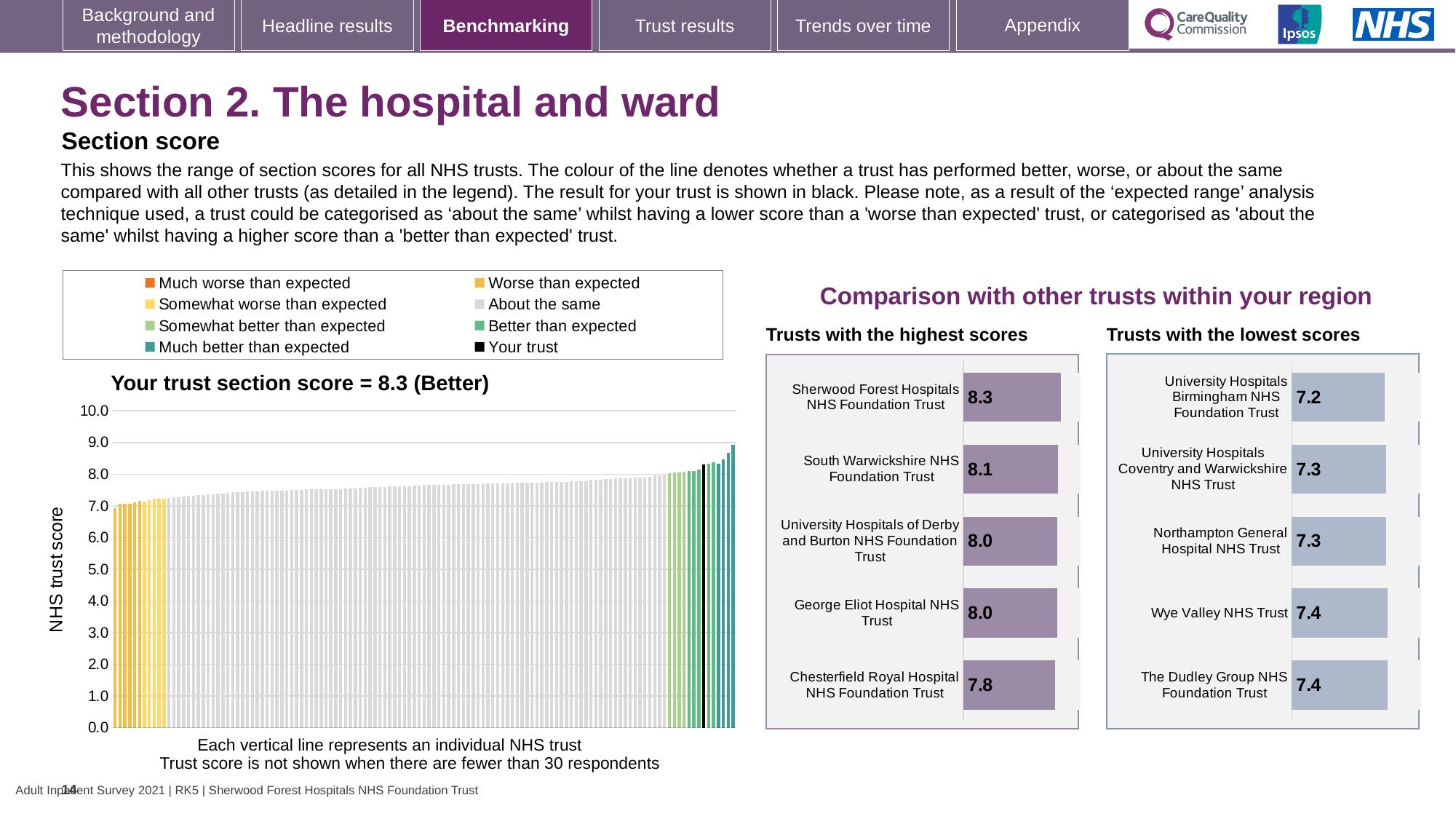
In the 'Your trust section score' chart, how many entries does the legend list? 8 In the 'Your trust section score' chart, what is the section score for your trust, as stated in the chart title? 8.3 In the 'Your trust section score' chart, do the bar heights rise or fall from left to right? Rise In the 'Your trust section score' chart, what kind of chart is shown? Bar chart In the 'Trusts with the highest scores' chart, which trust has the highest score? Sherwood Forest Hospitals NHS Foundation Trust In the 'Trusts with the lowest scores' chart, which has the larger score: Wye Valley NHS Trust or University Hospitals Birmingham NHS Foundation Trust? Wye Valley NHS Trust In the 'Trusts with the lowest scores' chart, which trust has the lowest score? University Hospitals Birmingham NHS Foundation Trust In the 'Trusts with the highest scores' chart, what is the score for South Warwickshire NHS Foundation Trust? 8.1 In the 'Trusts with the highest scores' chart, how many trusts are shown? 5 In the 'Your trust section score' chart, what is the label on the vertical axis? NHS trust score In the 'Trusts with the highest scores' chart, what is the difference between the scores of Sherwood Forest Hospitals NHS Foundation Trust and Chesterfield Royal Hospital NHS Foundation Trust? 0.5 In the 'Trusts with the lowest scores' chart, what is the score for Northampton General Hospital NHS Trust? 7.3